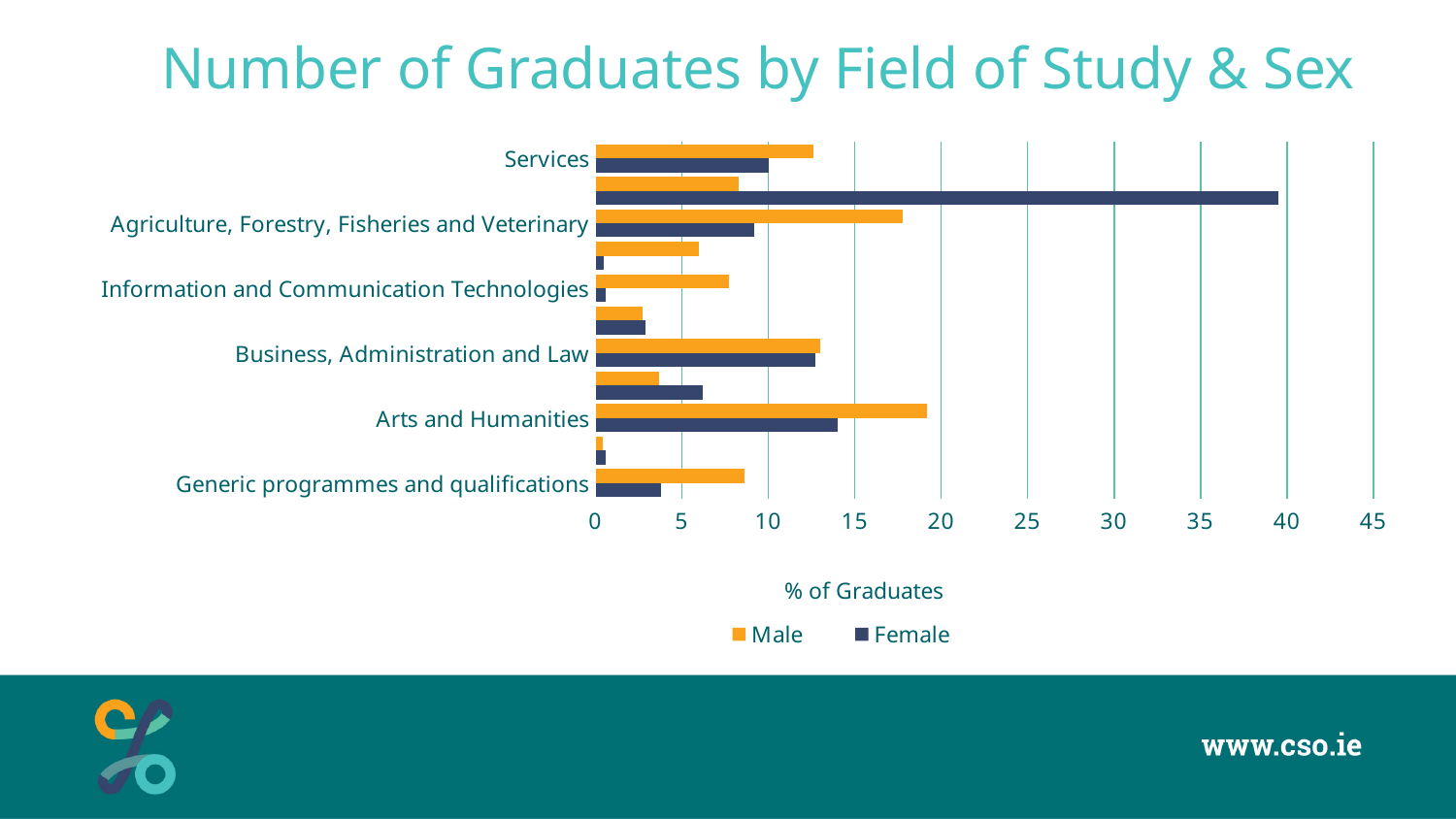
Is the Male value for Arts and Humanities greater or less than 20? less For Arts and Humanities, which is larger, the Male or the Female value? Male For Information and Communication Technologies, which is larger, the Male or the Female value? Male Is the Female value for Information and Communication Technologies greater or less than 5? less Is the Male value for Agriculture, Forestry, Fisheries and Veterinary greater or less than 15? greater Which colour represents Female in the chart? dark blue How many series does the legend list? 2 What kind of chart is shown on the slide? bar chart What is the label on the horizontal axis? % of Graduates Does the longest bar on the chart belong to the Male or the Female series? Female